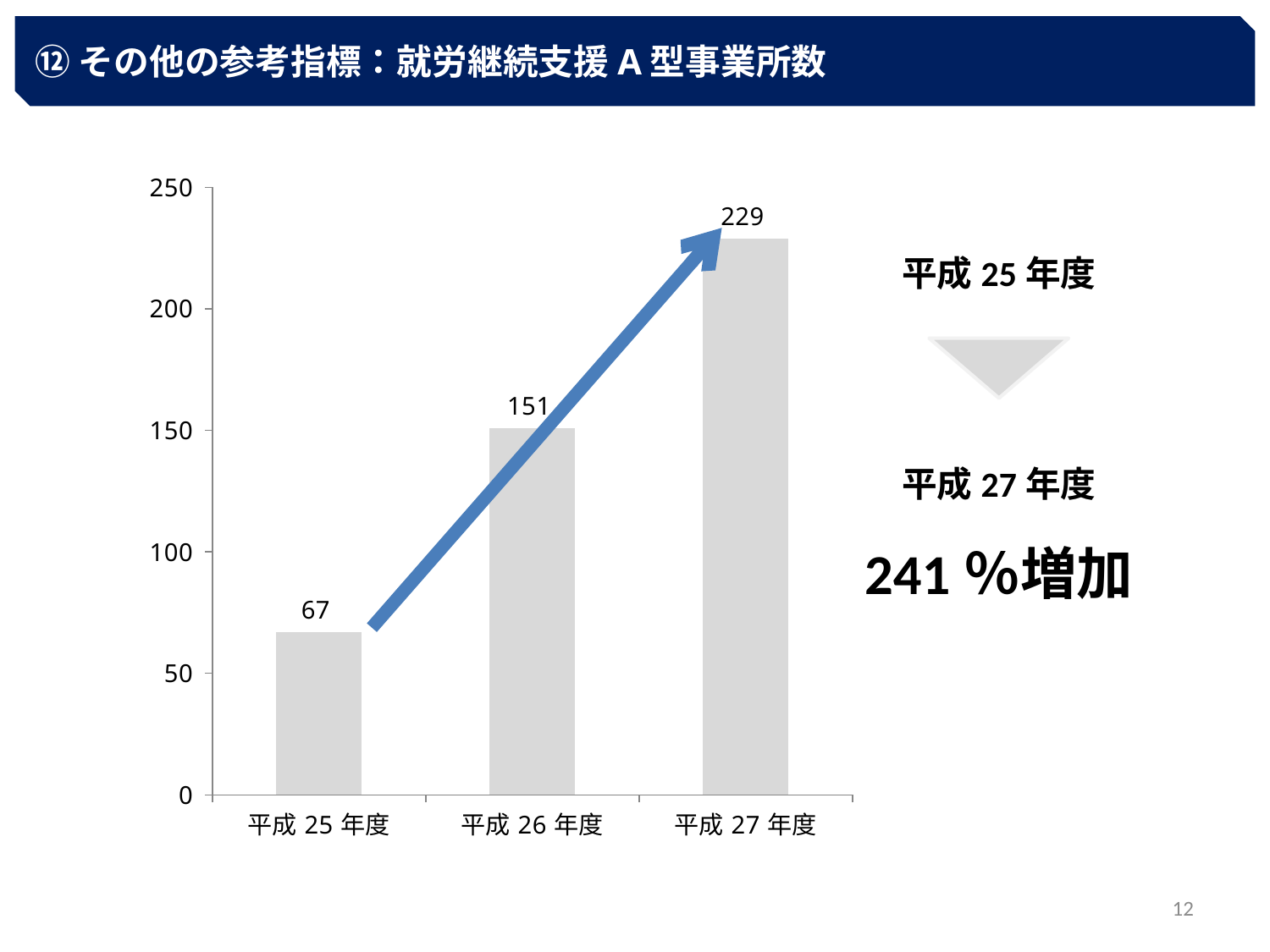
Do the values rise or fall from 平成 25 年度 to 平成 27 年度? rise What kind of chart is shown on the slide? bar chart What is the value for 平成 25 年度? 67 What is the value for 平成 26 年度? 151 How many categories are shown on the x axis? 3 Which is larger, the value for 平成 26 年度 or 平成 27 年度? 平成 27 年度 Which year has the highest value? 平成 27 年度 Which year has the lowest value? 平成 25 年度 Is the value for 平成 26 年度 greater or less than 100? greater What is the difference between the values for 平成 26 年度 and 平成 25 年度? 84 What is the value for 平成 27 年度? 229 What is the difference between the values for 平成 27 年度 and 平成 25 年度? 162